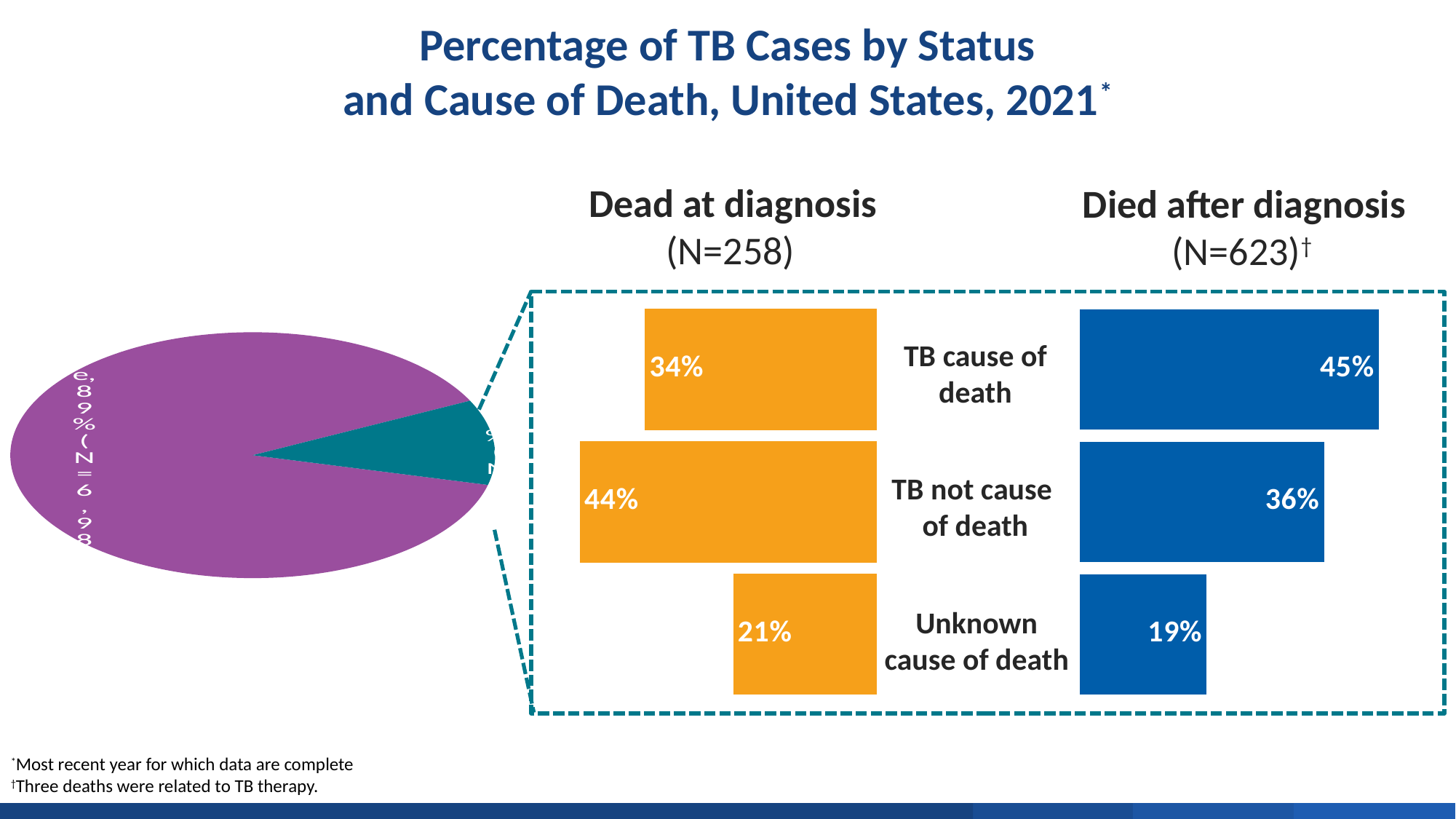
In the Died after diagnosis chart, which cause-of-death category has the lowest percentage? Unknown cause of death What type of chart is used to show the cause-of-death breakdown on the right side of the slide? Bar chart What colour are the bars for the Dead at diagnosis group? Orange In the Dead at diagnosis chart, what percentage of cases had TB as the cause of death? 34% What is the N for the Died after diagnosis group? 623 In the Dead at diagnosis chart, which cause-of-death category has the highest percentage? TB not cause of death How many cause-of-death categories are shown in the bar charts? 3 What is the difference between the TB cause of death percentages for Died after diagnosis and Dead at diagnosis? 11 percentage points In the Died after diagnosis chart, what percentage of cases had TB as the cause of death? 45% In the Dead at diagnosis chart, what percentage of cases had an unknown cause of death? 21% In the Died after diagnosis chart, what percentage of cases had TB not as the cause of death? 36% Which is larger: the Unknown cause of death percentage for Dead at diagnosis or for Died after diagnosis? Dead at diagnosis